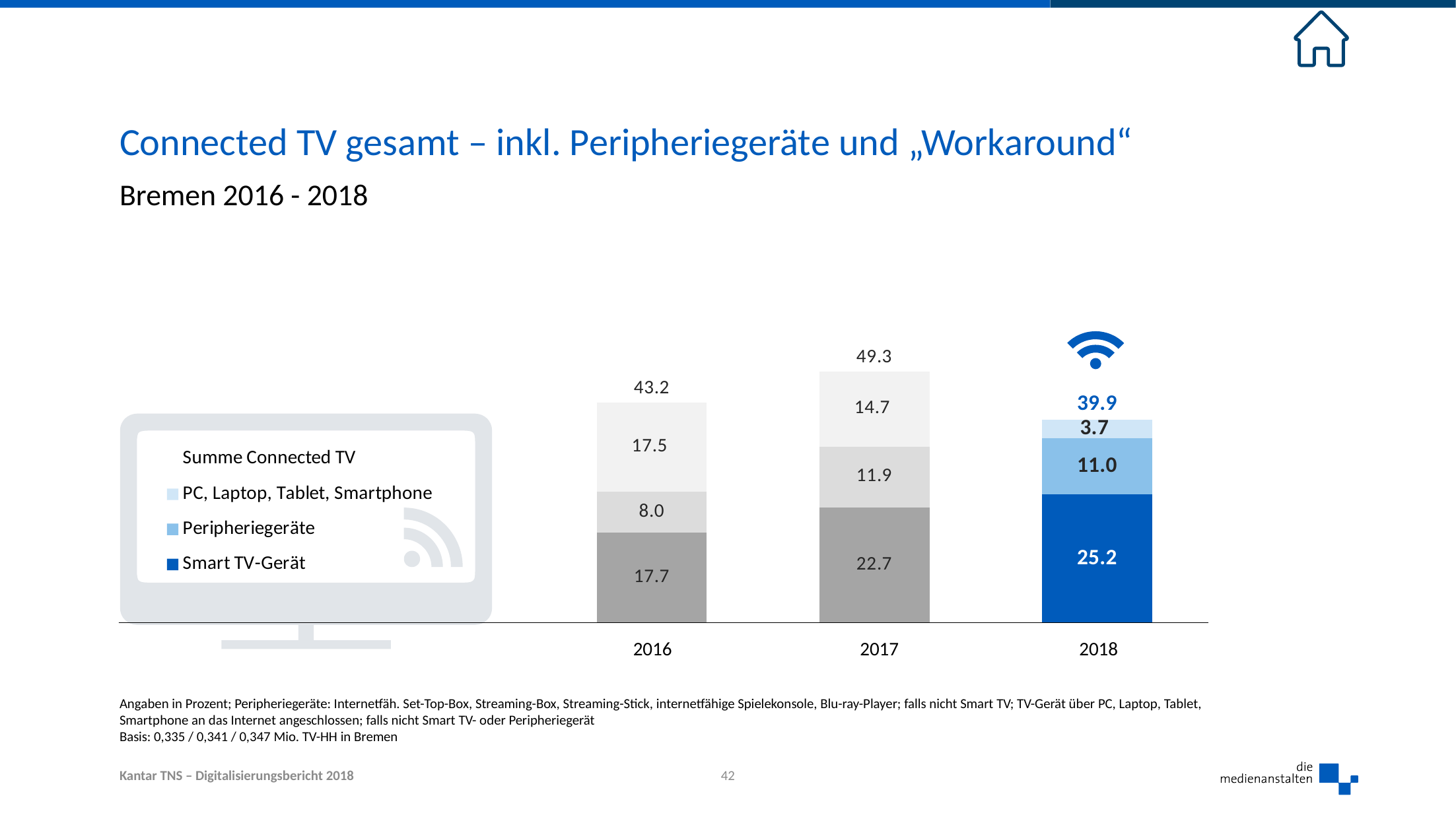
Which year has the highest Summe Connected TV total? 2017 How many years are shown on the x axis? 3 Which year has the lowest value for PC, Laptop, Tablet, Smartphone? 2018 What is the value for PC, Laptop, Tablet, Smartphone in 2016? 17.5 What is the difference between the Smart TV-Gerät values for 2018 and 2016? 7.5 What is the value for Smart TV-Gerät in 2018? 25.2 How many coloured series does the legend list? 3 Is the Peripheriegeräte value larger in 2017 or in 2018? 2017 What type of chart is shown on the slide? stacked bar chart What is the Summe Connected TV total for 2017? 49.3 What is the value for Peripheriegeräte in 2017? 11.9 Does the Smart TV-Gerät value rise or fall from 2016 to 2018? rise